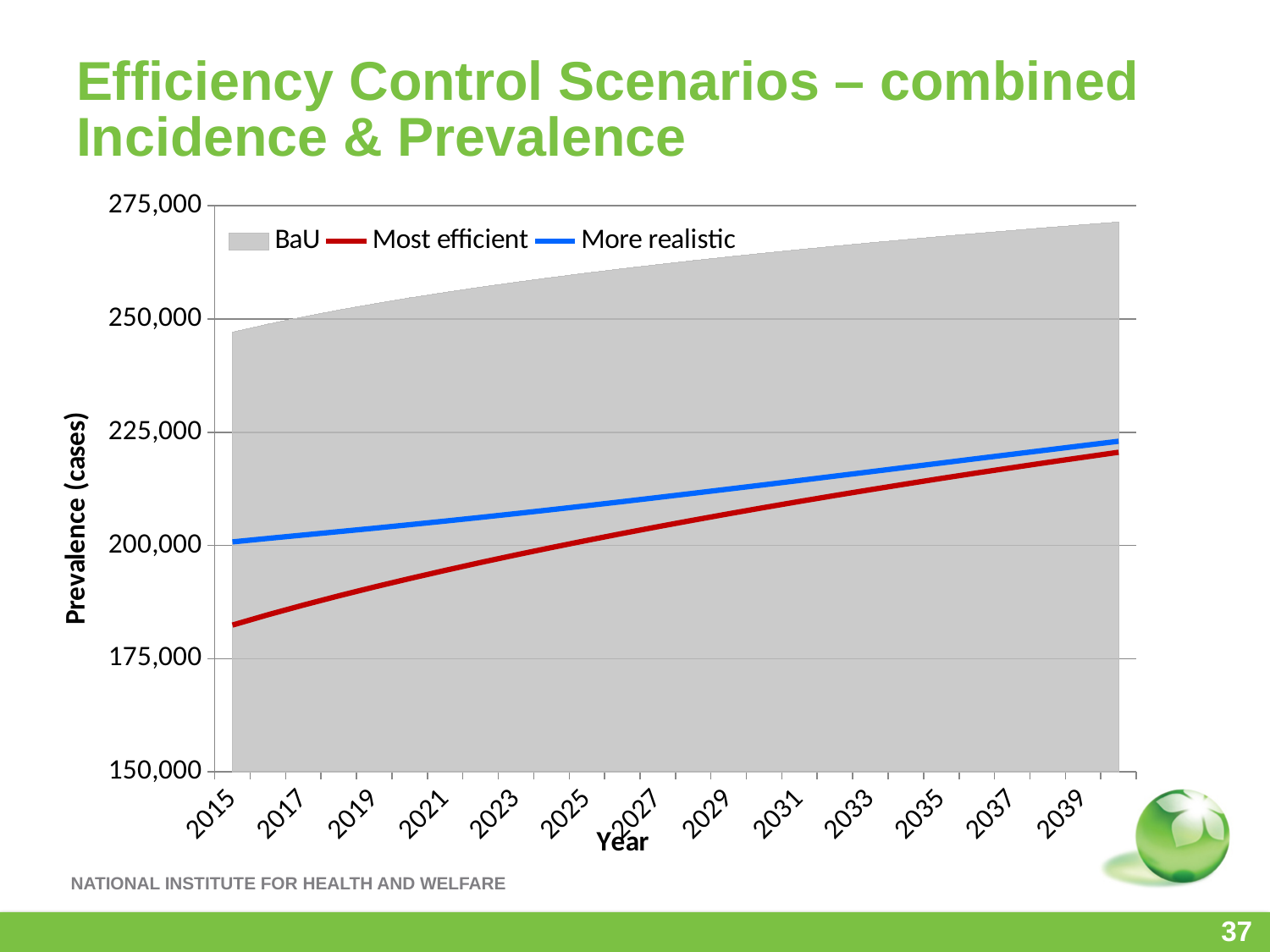
How many series does the legend list? 3 What are the three series named in the legend? BaU, Most efficient, More realistic Is the BaU value in 2039 greater or less than 250,000? greater Does the Most efficient series rise or fall from 2015 to 2039? rise Which series has the lowest prevalence in 2015? Most efficient Which series has the highest prevalence across all years? BaU What is the label of the y axis? Prevalence (cases) What kind of chart is shown on the slide? Area and line chart Is the Most efficient value in 2015 greater or less than 200,000? less Is the Most efficient value in 2039 greater or less than 225,000? less In 2015, which is larger: the Most efficient value or the More realistic value? More realistic